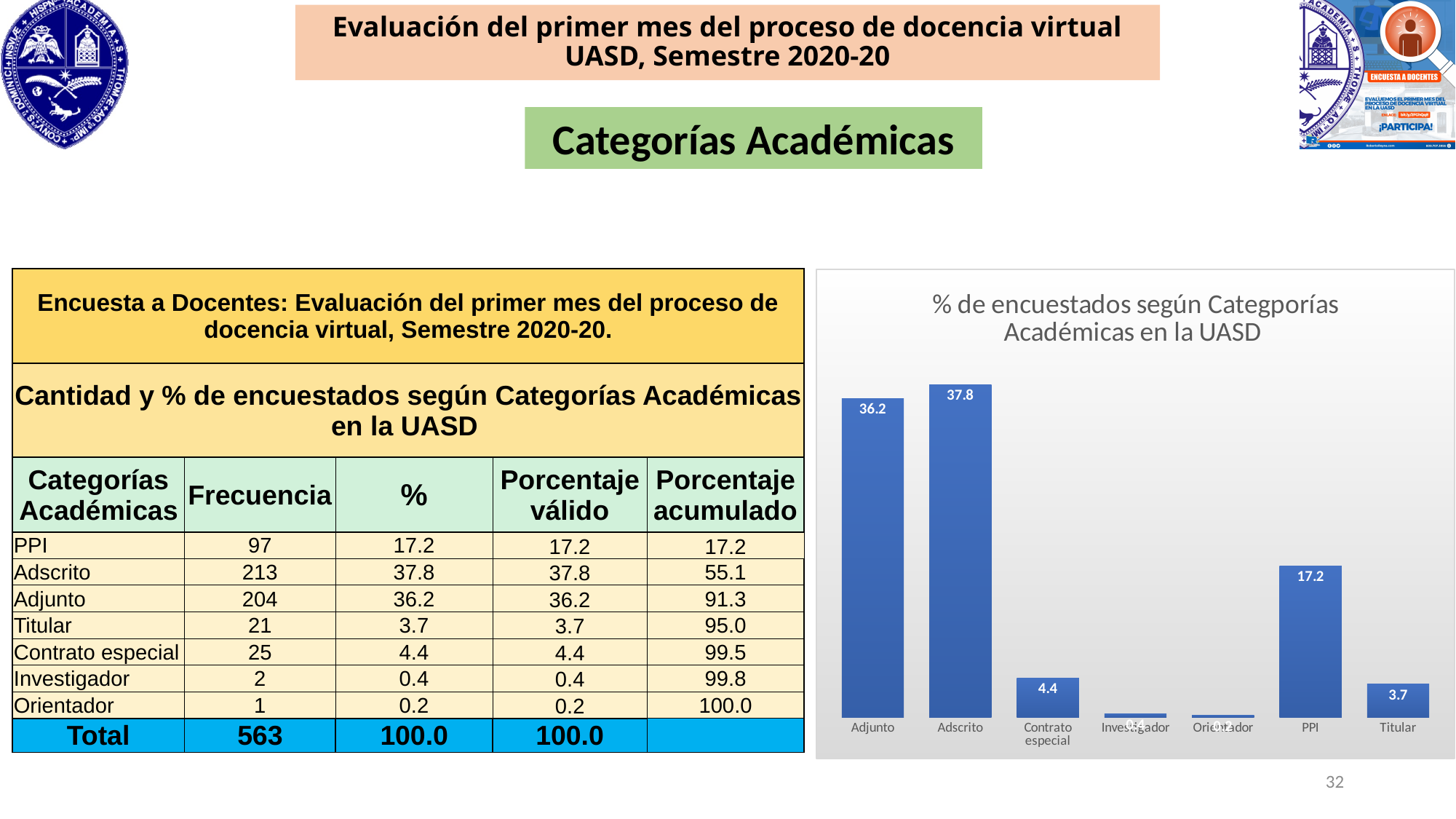
Which is larger in the chart, the value for PPI or the value for Contrato especial? PPI How many categories are plotted in the chart? 7 What is the value shown for Contrato especial in the chart? 4.4 What is the value shown for PPI in the chart? 17.2 What is the value shown for Adscrito in the chart? 37.8 Which category has the highest value in the chart? Adscrito What is the title of the chart on the slide? % de encuestados según Categporías Académicas en la UASD What is the difference between the values for Adscrito and Adjunto in the chart? 1.6 What type of chart is shown on the slide? bar chart What is the value shown for Titular in the chart? 3.7 What is the difference between the values for PPI and Titular in the chart? 13.5 What is the value shown for Adjunto in the chart? 36.2